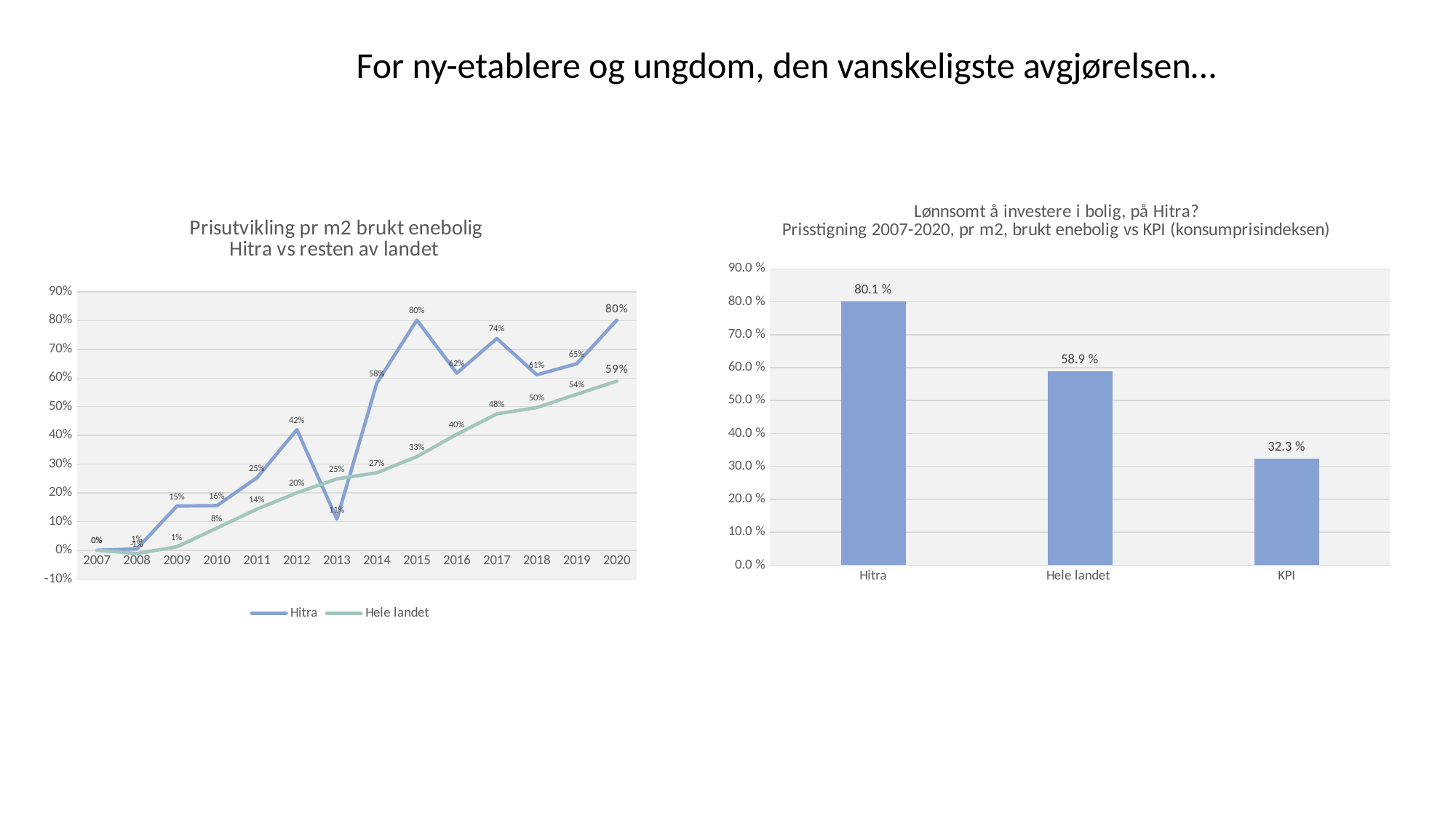
What kind of chart is the right-hand chart (Lønnsomt å investere i bolig, på Hitra?)? Bar chart In the right-hand chart (Lønnsomt å investere i bolig, på Hitra?), what is the value for KPI? 32.3 % In the right-hand chart (Lønnsomt å investere i bolig, på Hitra?), which category has the highest value? Hitra In the right-hand chart (Lønnsomt å investere i bolig, på Hitra?), how many bars are shown? 3 In the right-hand chart (Lønnsomt å investere i bolig, på Hitra?), what is the difference between the Hitra value and the KPI value? 47.8 % In the right-hand chart (Lønnsomt å investere i bolig, på Hitra?), what is the value for Hele landet? 58.9 % In the left-hand chart (Prisutvikling pr m2 brukt enebolig), what is the Hele landet value for 2020? 59% In the left-hand chart (Prisutvikling pr m2 brukt enebolig), does the Hele landet series generally rise or fall from 2007 to 2020? Rise In the right-hand chart (Lønnsomt å investere i bolig, på Hitra?), which category has the lowest value? KPI In the left-hand chart (Prisutvikling pr m2 brukt enebolig), what is the Hitra value for 2015? 80% In the left-hand chart (Prisutvikling pr m2 brukt enebolig), which series has the higher value in 2013, Hitra or Hele landet? Hele landet In the left-hand chart (Prisutvikling pr m2 brukt enebolig), how many series does the legend list? 2